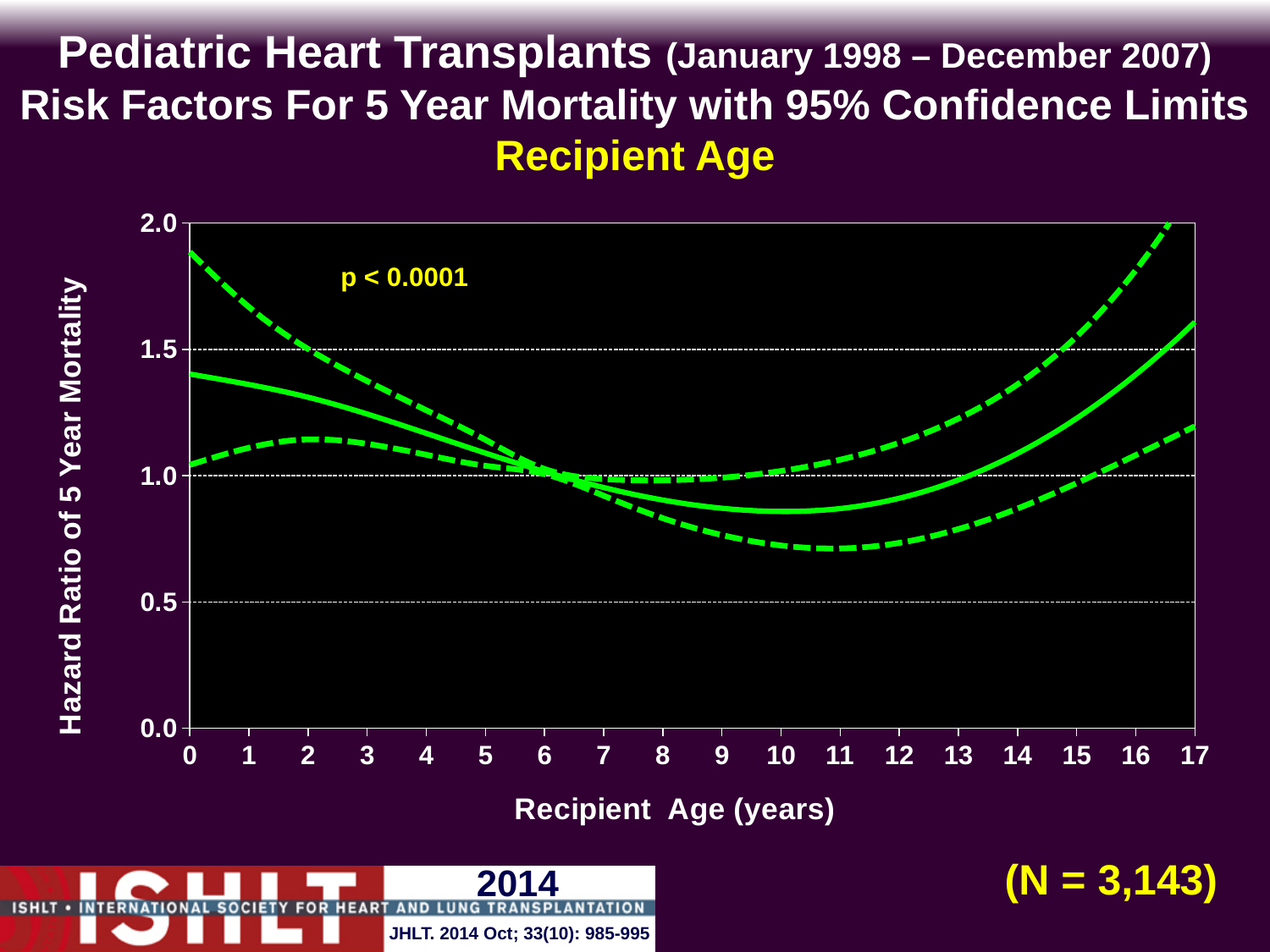
Is the lower dashed confidence limit at recipient age 11 greater or less than 1.0? less Is the hazard ratio on the solid line at recipient age 0 greater or less than 1.0? greater Is the hazard ratio on the solid line at recipient age 10 greater or less than 1.0? less Does the solid hazard ratio line rise or fall between recipient age 0 and recipient age 10? fall What is the label of the x axis? Recipient Age (years) Does the solid hazard ratio line rise or fall between recipient age 11 and recipient age 17? rise What is the highest value shown on the y axis? 2.0 How many lines are plotted on the chart? 3 What kind of chart is shown on the slide? line chart What is the label of the y axis? Hazard Ratio of 5 Year Mortality